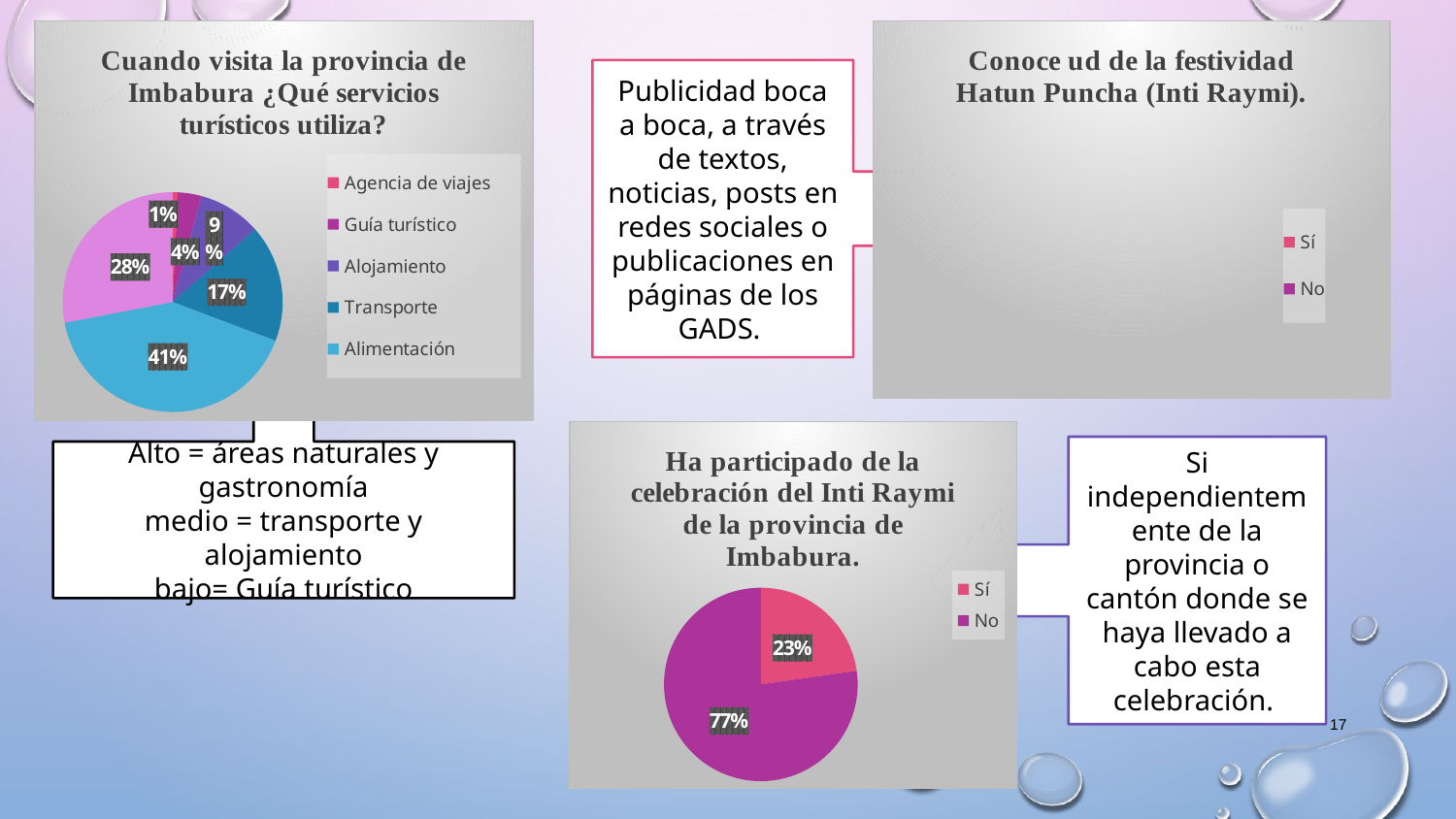
In the chart titled 'Ha participado de la celebración del Inti Raymi de la provincia de Imbabura', which response has the larger share? No What are the two legend entries in the chart titled 'Conoce ud de la festividad Hatun Puncha (Inti Raymi)'? Sí and No How many entries does the legend list in the chart titled 'Cuando visita la provincia de Imbabura ¿Qué servicios turísticos utiliza?'? 5 What kind of chart is the one titled 'Ha participado de la celebración del Inti Raymi de la provincia de Imbabura'? Pie chart In the chart titled 'Cuando visita la provincia de Imbabura ¿Qué servicios turísticos utiliza?', what percentage corresponds to Agencia de viajes? 1% In the chart titled 'Ha participado de la celebración del Inti Raymi de la provincia de Imbabura', what percentage answered 'Sí'? 23% In the chart titled 'Cuando visita la provincia de Imbabura ¿Qué servicios turísticos utiliza?', what is the largest percentage shown on any slice? 41% In the chart titled 'Cuando visita la provincia de Imbabura ¿Qué servicios turísticos utiliza?', what percentage corresponds to Transporte? 17% In the chart titled 'Ha participado de la celebración del Inti Raymi de la provincia de Imbabura', what is the difference in percentage points between 'No' and 'Sí'? 54 In the chart titled 'Cuando visita la provincia de Imbabura ¿Qué servicios turísticos utiliza?', what percentage corresponds to Alimentación? 41% In the chart titled 'Cuando visita la provincia de Imbabura ¿Qué servicios turísticos utiliza?', which is larger, Transporte or Alojamiento? Transporte In the chart titled 'Ha participado de la celebración del Inti Raymi de la provincia de Imbabura', what percentage answered 'No'? 77%